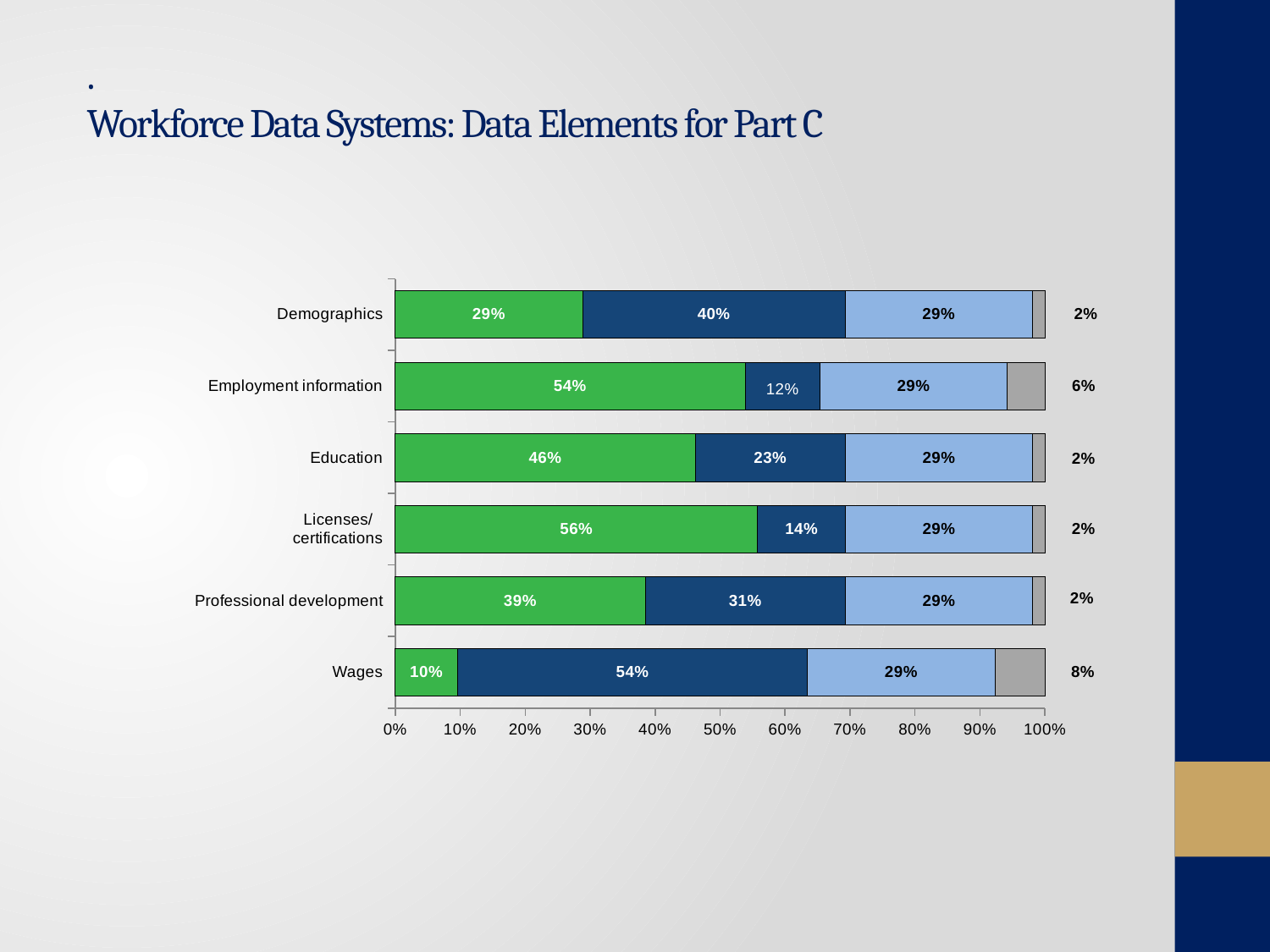
What is the value of the grey segment for Employment information? 6% What is the value of the green segment for Wages? 10% Which category has the smallest green segment? Wages Which is larger: the dark blue segment for Wages or the dark blue segment for Professional development? Wages Which category has the largest green segment? Licenses/certifications Which category has the largest grey segment? Wages How many categories are plotted on the chart? 6 What is the title of the slide containing the chart? Workforce Data Systems: Data Elements for Part C What is the value of the dark blue segment for Licenses/certifications? 14% What is the value of the dark blue segment for Demographics? 40% What kind of chart is shown on the slide? Stacked bar chart What is the difference between the green segment for Education and the green segment for Professional development? 7%